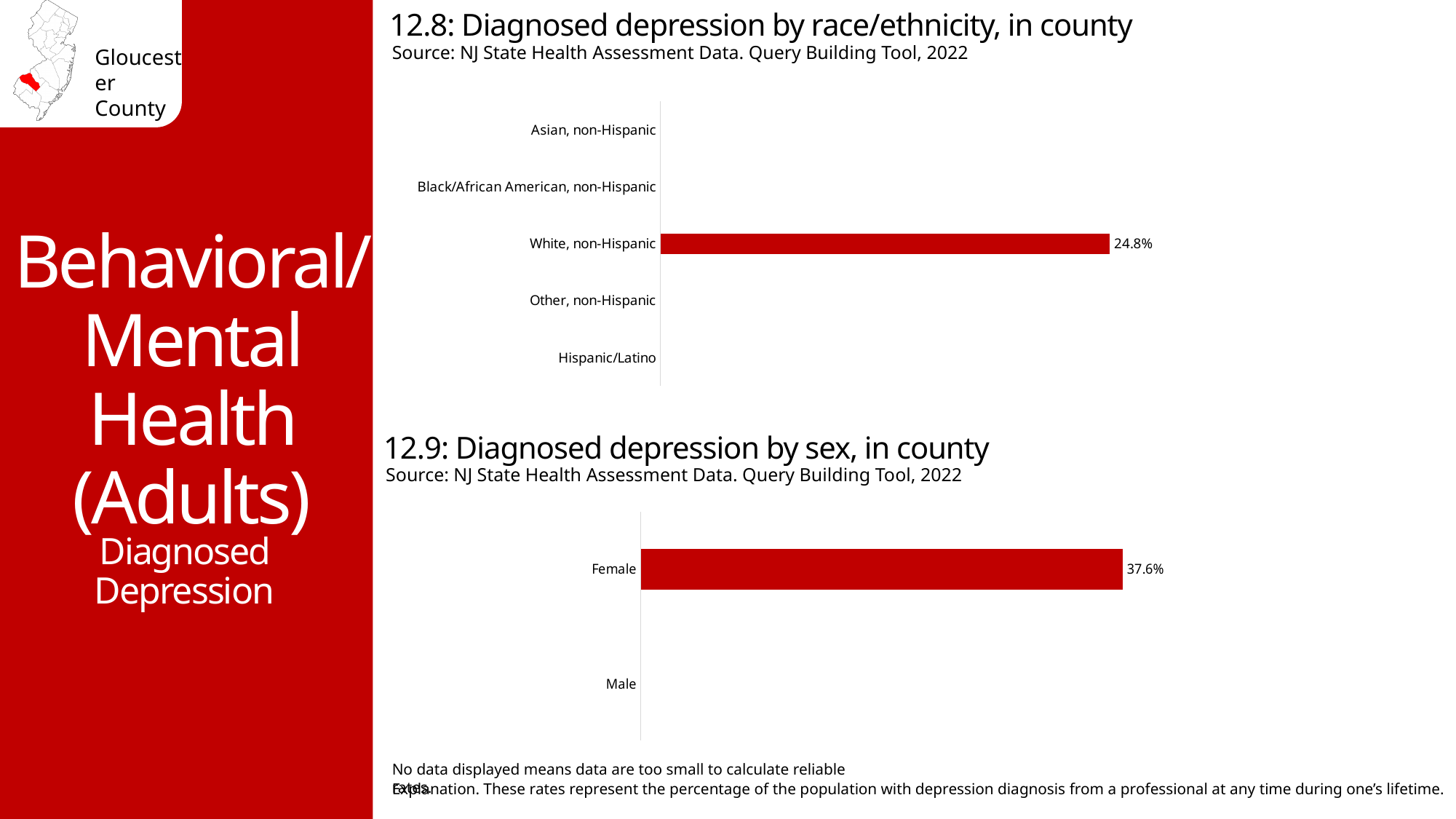
In the chart '12.9: Diagnosed depression by sex, in county', what is the value for Female? 37.6% How many race/ethnicity categories are listed on the axis of the chart '12.8: Diagnosed depression by race/ethnicity, in county'? 5 Which is larger: the Female value in chart 12.9 or the White, non-Hispanic value in chart 12.8? Female In the chart '12.8: Diagnosed depression by race/ethnicity, in county', which category is the only one with a bar displayed? White, non-Hispanic What kind of chart is '12.9: Diagnosed depression by sex, in county'? Bar chart In the chart '12.8: Diagnosed depression by race/ethnicity, in county', which category is listed first at the top of the axis? Asian, non-Hispanic What is the difference between the Female value in chart 12.9 (37.6%) and the White, non-Hispanic value in chart 12.8 (24.8%)? 12.8% In the chart '12.9: Diagnosed depression by sex, in county', which category has no bar displayed? Male What kind of chart is '12.8: Diagnosed depression by race/ethnicity, in county'? Bar chart How many categories are listed on the axis of the chart '12.9: Diagnosed depression by sex, in county'? 2 In the chart '12.8: Diagnosed depression by race/ethnicity, in county', what is the value for White, non-Hispanic? 24.8%